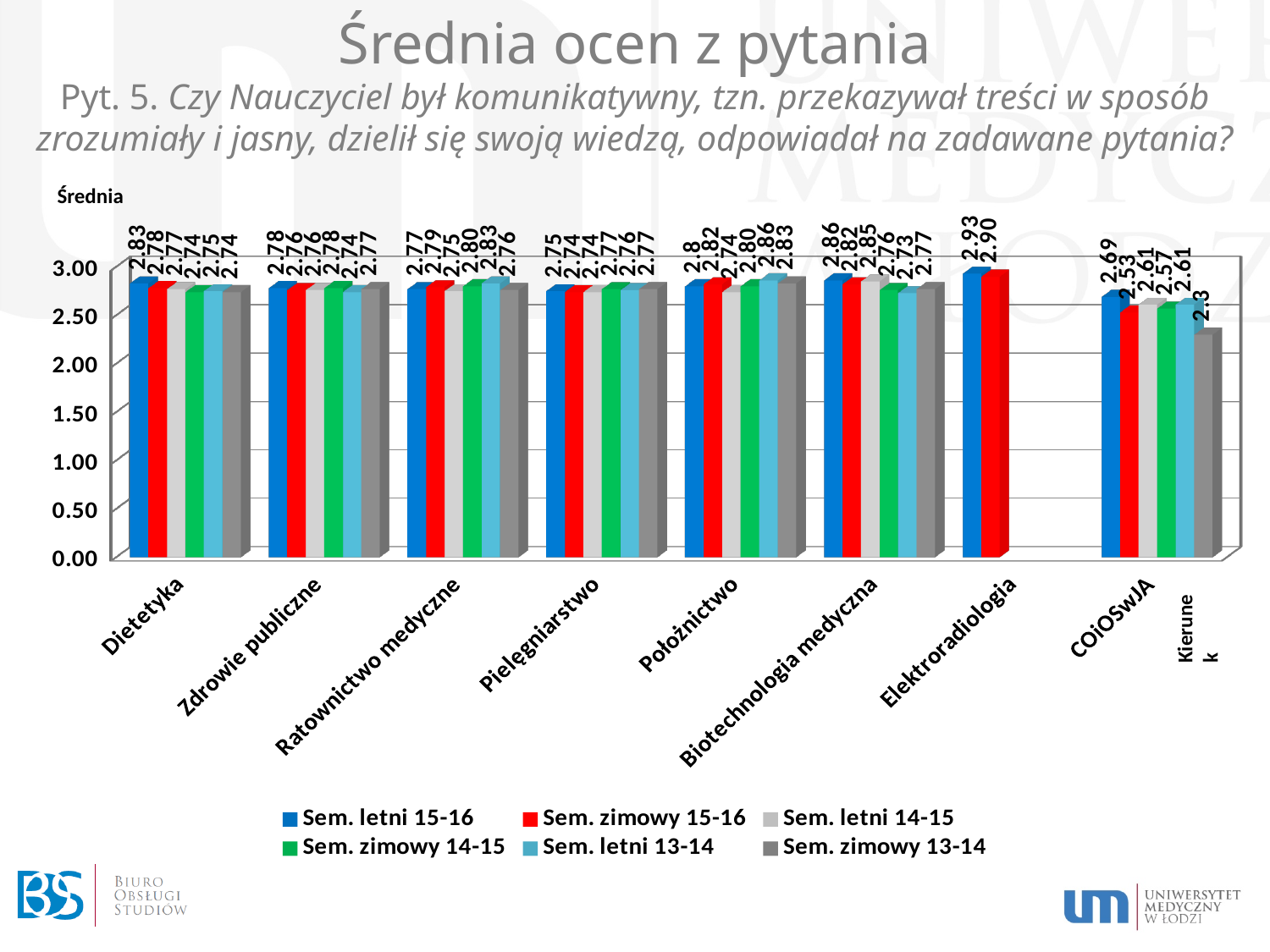
Is the value for COiOSwJA in the Sem. zimowy 13-14 series greater or less than 2.50? less What is the difference between the Sem. letni 15-16 and Sem. zimowy 15-16 values for Elektroradiologia? 0.03 What is the value for Dietetyka in the Sem. letni 15-16 series? 2.83 Which is larger in the Sem. zimowy 15-16 series: Dietetyka or COiOSwJA? Dietetyka How many categories (kierunki) are shown on the x axis? 8 Which category has the lowest value in the Sem. letni 15-16 series? COiOSwJA What kind of chart is shown on the slide? bar chart What is the value for COiOSwJA in the Sem. zimowy 13-14 series? 2.3 What is the value for Elektroradiologia in the Sem. zimowy 15-16 series? 2.90 How many series does the legend list? 6 Which category has the highest value in the Sem. letni 15-16 series? Elektroradiologia What is the difference between the Sem. letni 15-16 and Sem. zimowy 15-16 values for COiOSwJA? 0.16